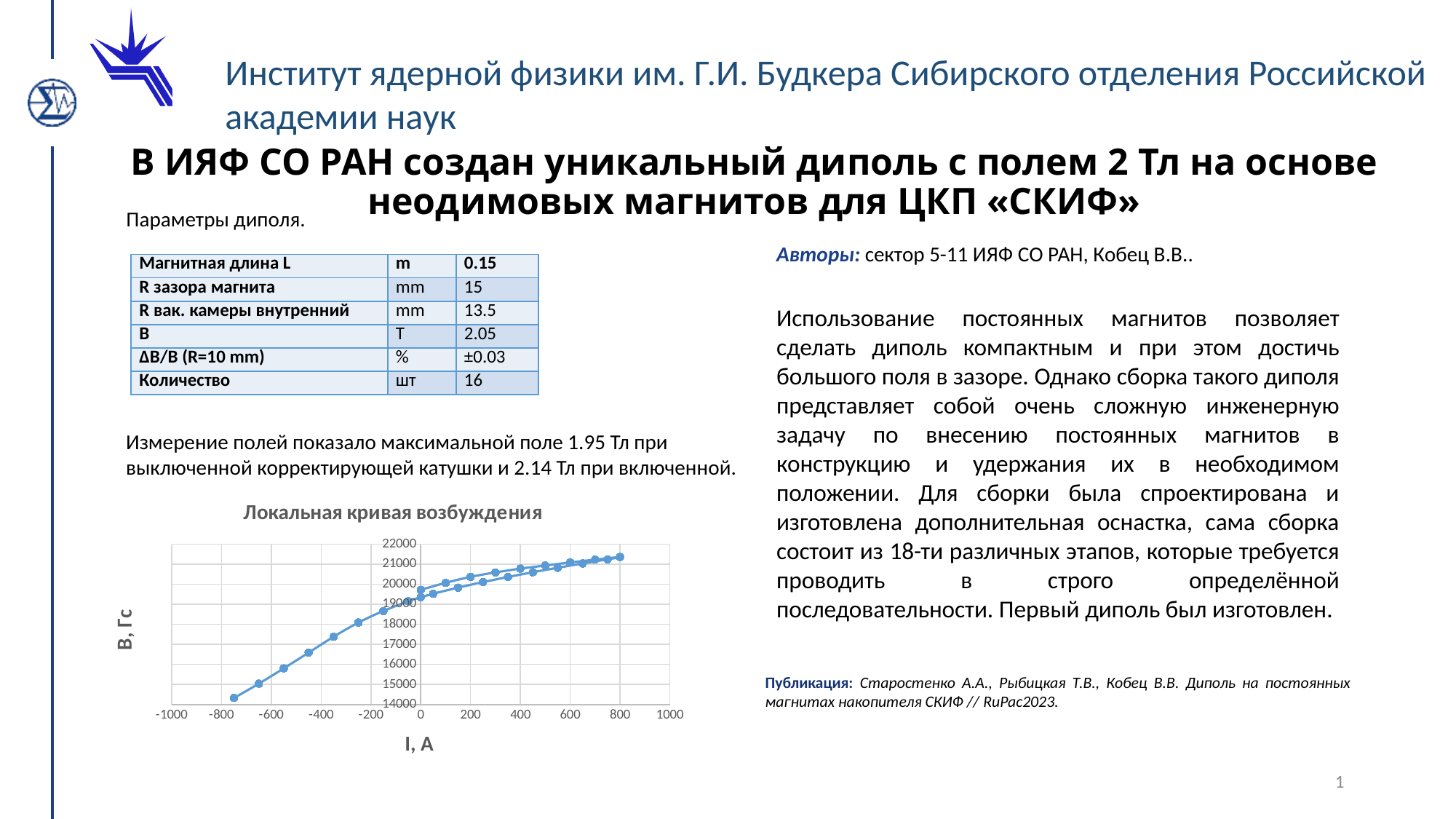
Which plotted point has the lowest B value: the one near I = -750 A or the one near I = 800 A? the one near I = -750 A What is the highest tick value shown on the vertical axis of the chart? 22000 What is the title of the chart on the slide? Локальная кривая возбуждения Do the plotted values of B rise or fall as I increases along the x axis? rise Is the value of B at I = 0 A greater or less than 21000? less Is the value of B at the rightmost plotted point (near I = 800 A) greater or less than 20000? greater What is the label of the vertical axis of the chart? B, Гс What kind of chart is shown under the title "Локальная кривая возбуждения"? line chart with markers (scatter) Is the value of B at I = 0 A greater or less than 18000? greater